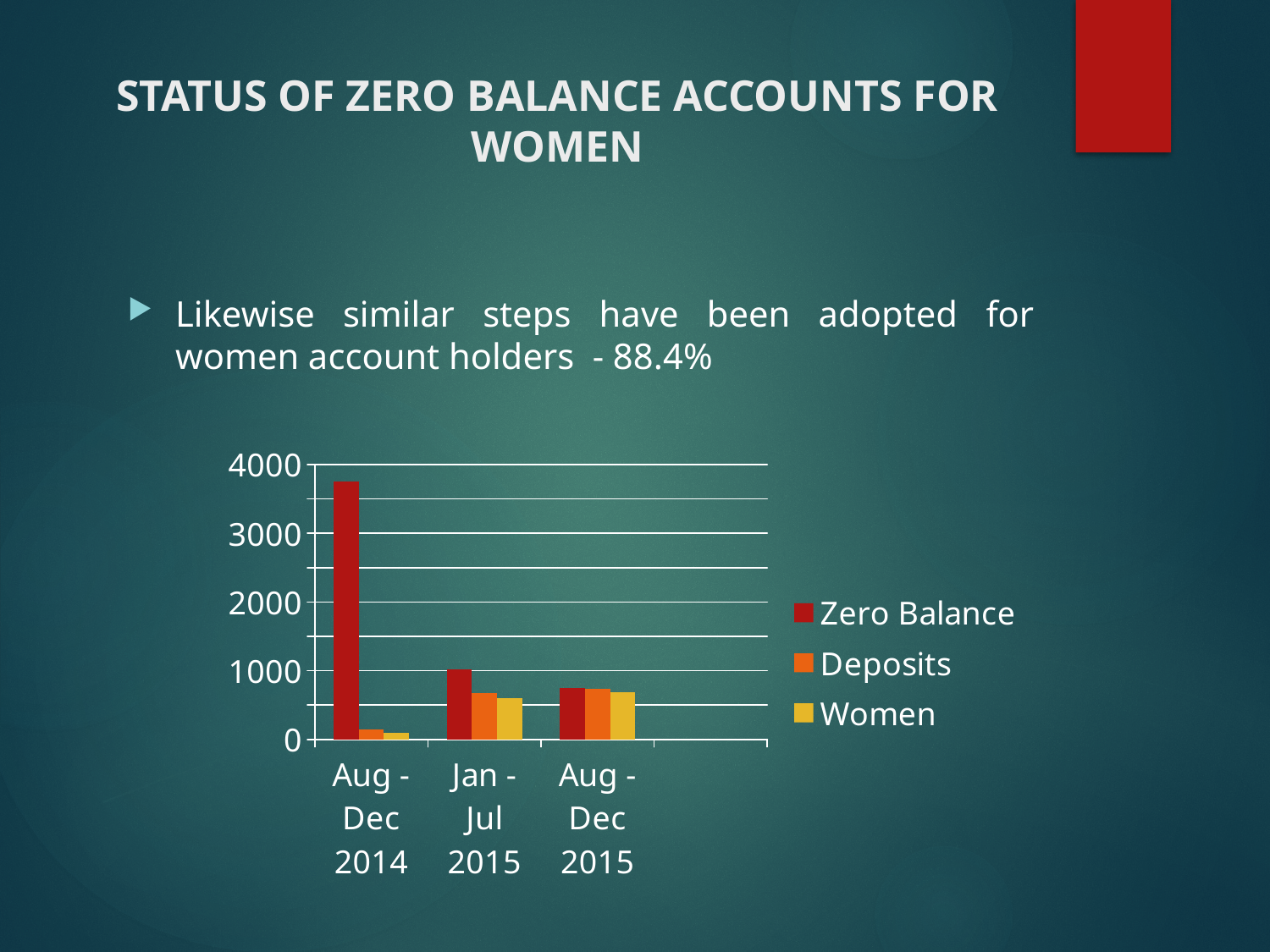
What kind of chart is shown on the slide? bar chart Is the Women value for Jan - Jul 2015 greater or less than 1000? less Does the Zero Balance value rise or fall from Aug - Dec 2014 to Aug - Dec 2015? fall Which series are listed in the chart's legend? Zero Balance, Deposits, Women What colour are the Zero Balance bars in the chart? red In Aug - Dec 2014, which is larger: Zero Balance or Deposits? Zero Balance In which period is the Zero Balance value highest? Aug - Dec 2014 Is the Zero Balance value for Aug - Dec 2014 greater or less than 3000? greater In which period is the Zero Balance value lowest? Aug - Dec 2015 How many time periods are shown on the x axis of the chart? 3 How many series does the chart's legend list? 3 Is the Deposits value for Aug - Dec 2014 greater or less than 1000? less